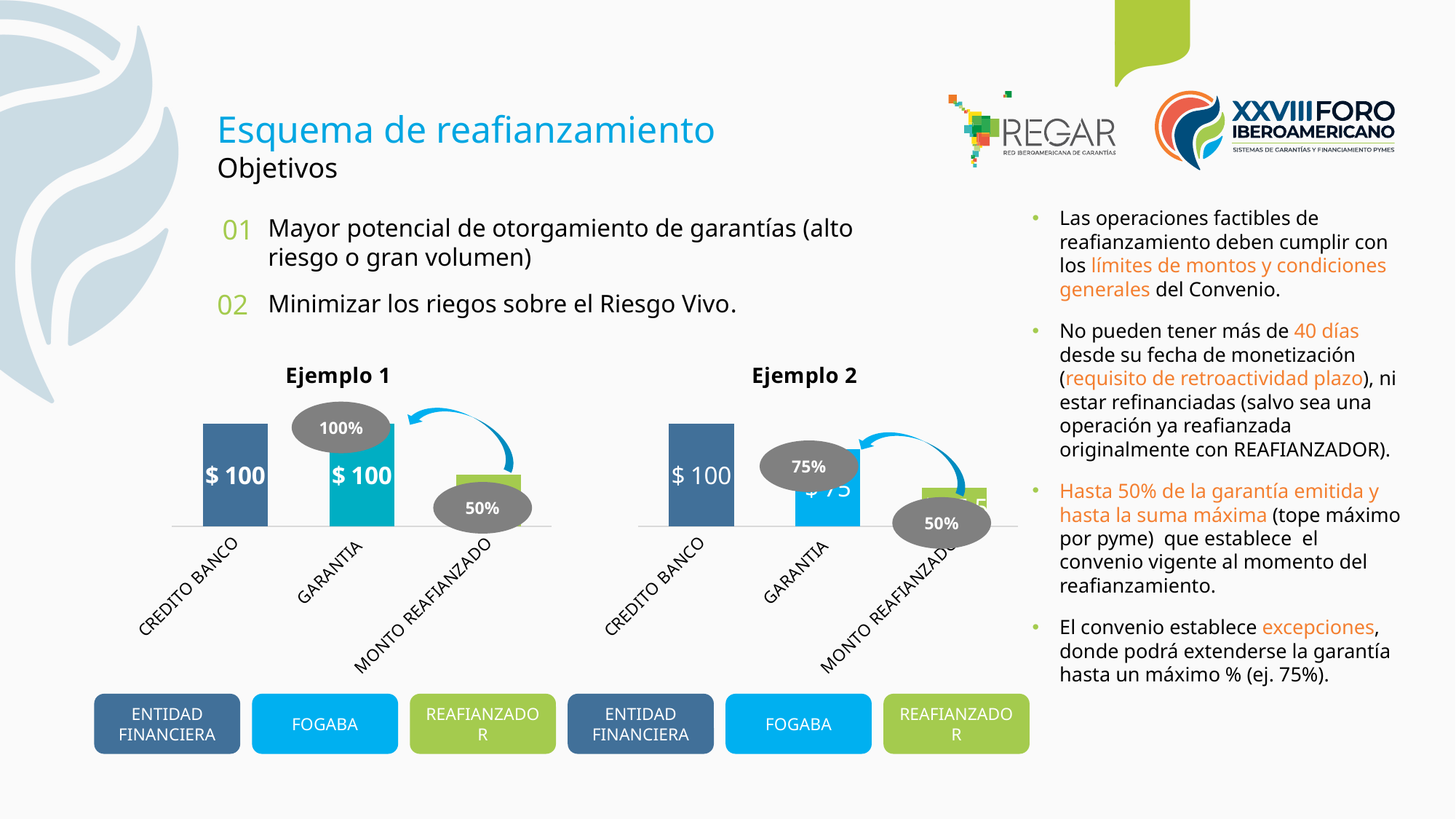
In the Ejemplo 2 chart, what is the value for CREDITO BANCO? $ 100 In the Ejemplo 2 chart, which is larger: CREDITO BANCO or GARANTIA? CREDITO BANCO What type of chart is used for Ejemplo 1? bar chart How many categories are shown on the x axis of the Ejemplo 2 chart? 3 In the Ejemplo 1 chart, what is the value for CREDITO BANCO? $ 100 In the Ejemplo 2 chart, what percentage is shown in the grey bubble over the GARANTIA bar? 75% In the Ejemplo 1 chart, which category has the lowest value? MONTO REAFIANZADO In the Ejemplo 2 chart, what is the difference between CREDITO BANCO and GARANTIA? $ 25 In the Ejemplo 1 chart, what is the value for GARANTIA? $ 100 In the Ejemplo 2 chart, do the values rise or fall from left to right along the x axis? fall In the Ejemplo 2 chart, what is the value for GARANTIA? $ 75 In the Ejemplo 2 chart, which category has the highest value? CREDITO BANCO